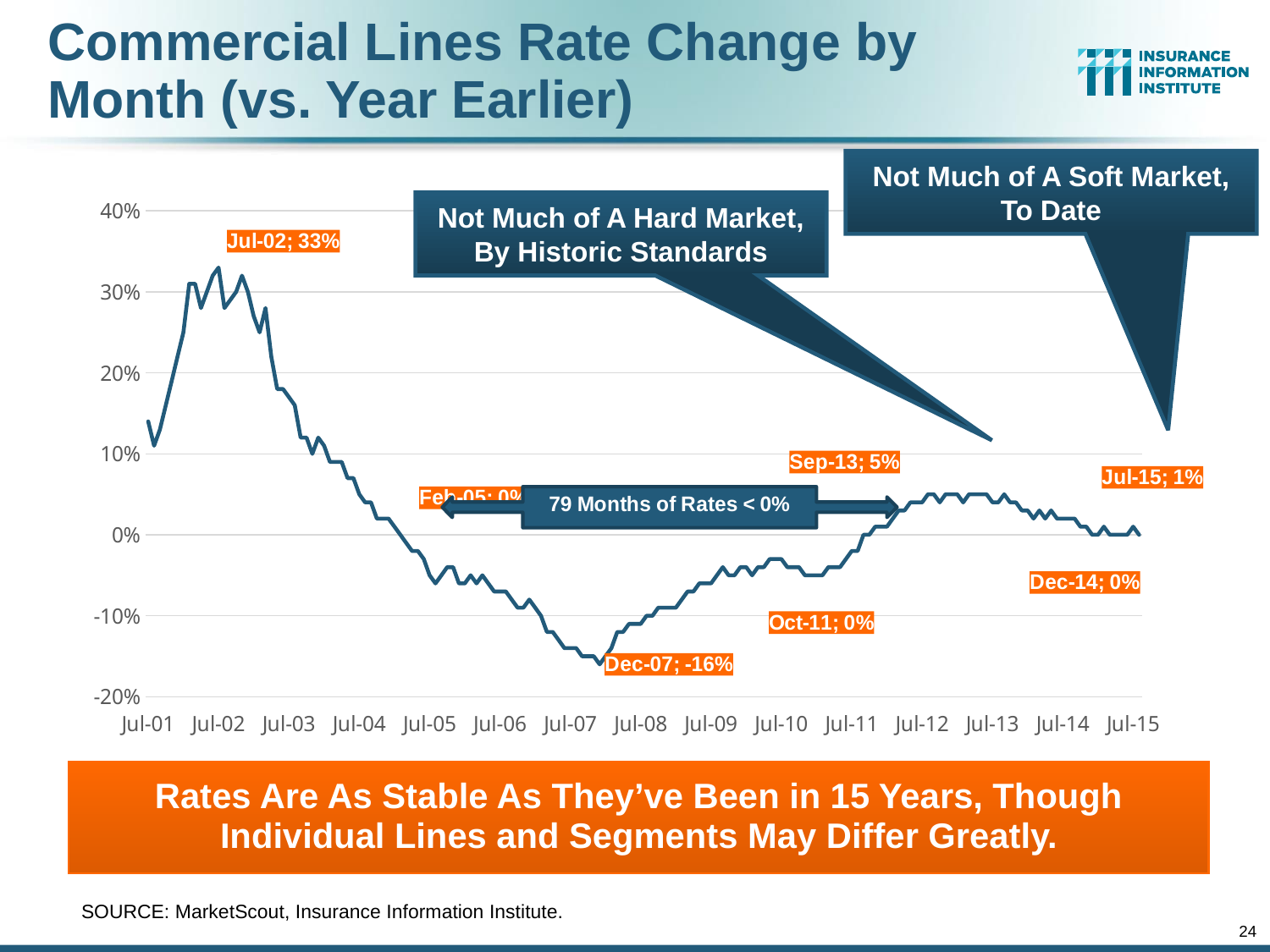
What was the commercial lines rate change in Jul-15? 1% Which is larger, the rate change in Sep-13 or the rate change in Jul-15? Sep-13 What was the commercial lines rate change in Dec-07? -16% Which labeled month shows the highest rate change? Jul-02 What kind of chart is shown on the slide? Line chart What was the commercial lines rate change in Sep-13? 5% What was the commercial lines rate change in Jul-02? 33% Which labeled month shows the lowest rate change? Dec-07 What was the commercial lines rate change in Oct-11? 0% What is the difference between the rate change in Jul-02 and the rate change in Dec-07? 49 percentage points Is the rate change in Jul-01 greater or less than 10%? greater According to the annotation on the chart, for how many months were rates below 0%? 79 months